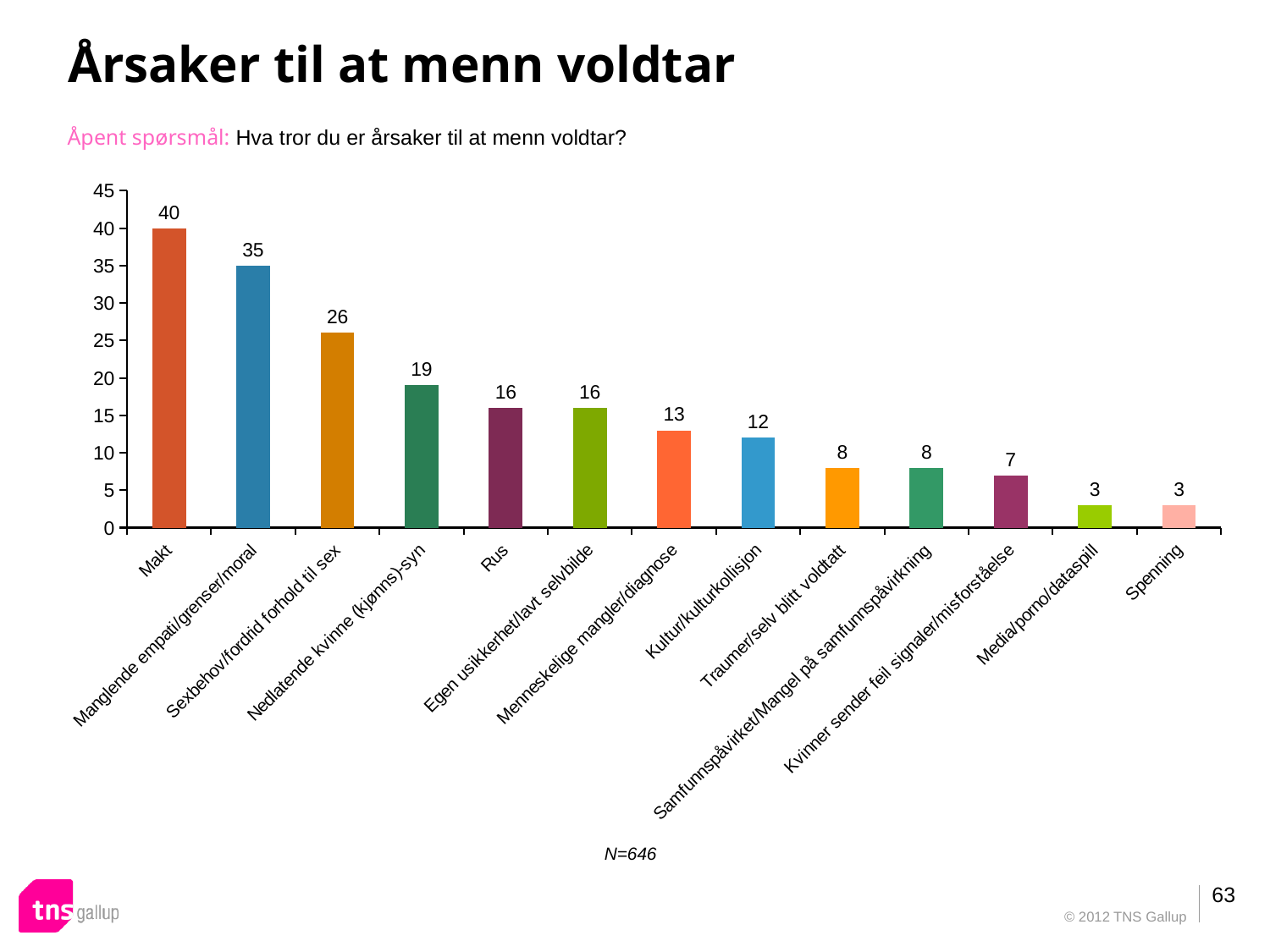
Do the values rise or fall from left to right along the x axis? fall What is the value for Makt? 40 What is the sample size (N) shown below the chart? N=646 Which is larger, the value for Nedlatende kvinne (kjønns)-syn or the value for Rus? Nedlatende kvinne (kjønns)-syn What is the value for Kultur/kulturkollisjon? 12 How many categories are shown on the x axis? 13 What is the difference between the values for Makt and Manglende empati/grenser/moral? 5 What kind of chart is shown on the slide? bar chart What is the value for Kvinner sender feil signaler/misforståelse? 7 Is the value for Menneskelige mangler/diagnose greater or less than 10? greater What is the value for Sexbehov/fordrid forhold til sex? 26 Which category has the highest value? Makt